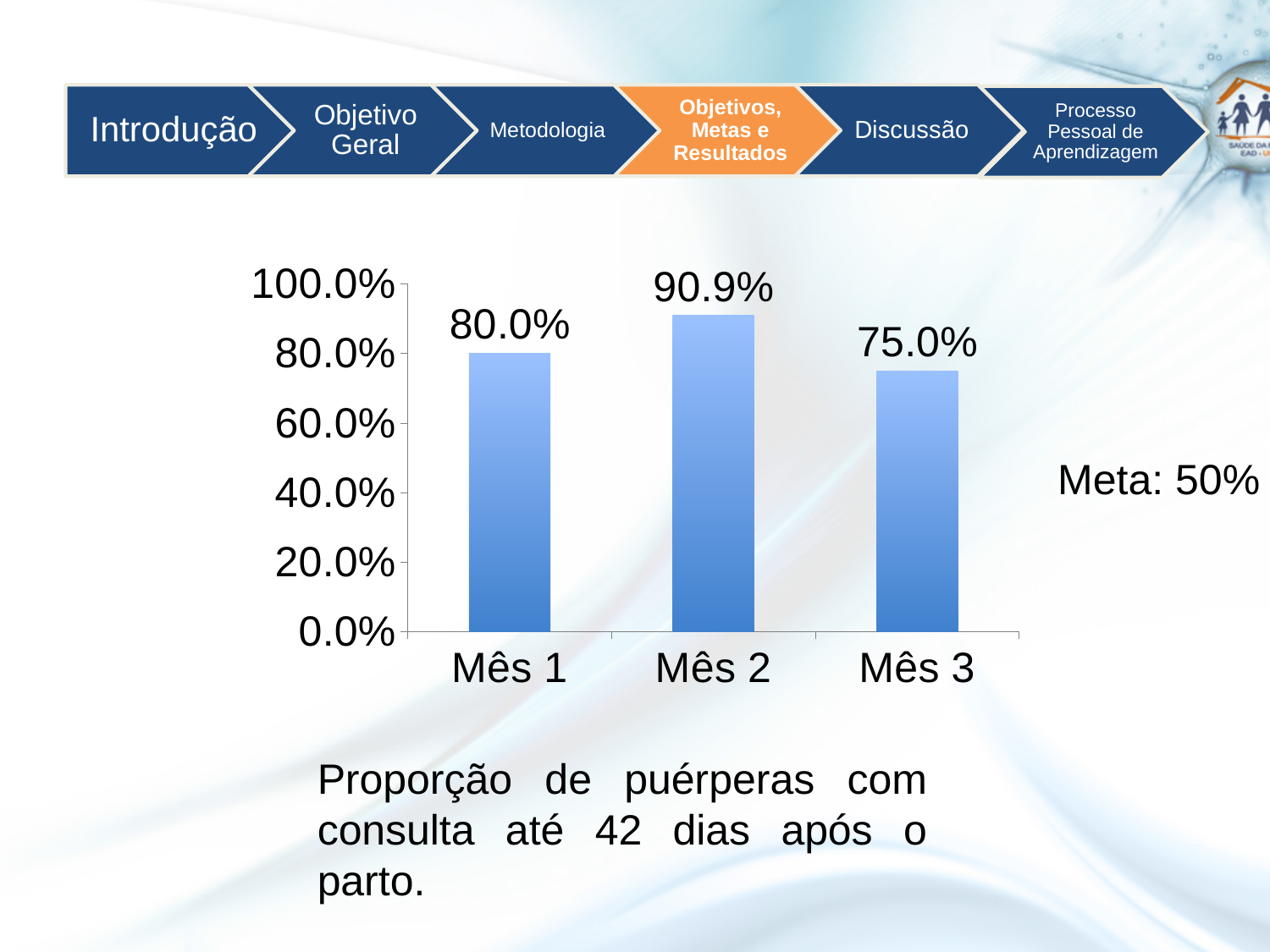
Which is larger, the value for Mês 1 or the value for Mês 2? Mês 2 Which month has the highest value? Mês 2 What is the value for Mês 3? 75.0% What kind of chart is shown on the slide? bar chart What is the difference between the values for Mês 1 and Mês 3? 5.0% What is the value for Mês 2? 90.9% Is the value for Mês 3 greater or less than 60.0%? greater Which month has the lowest value? Mês 3 What is the value for Mês 1? 80.0% What is the difference between the values for Mês 2 and Mês 3? 15.9% How many months are shown on the x axis? 3 What target (Meta) is stated next to the chart? 50%